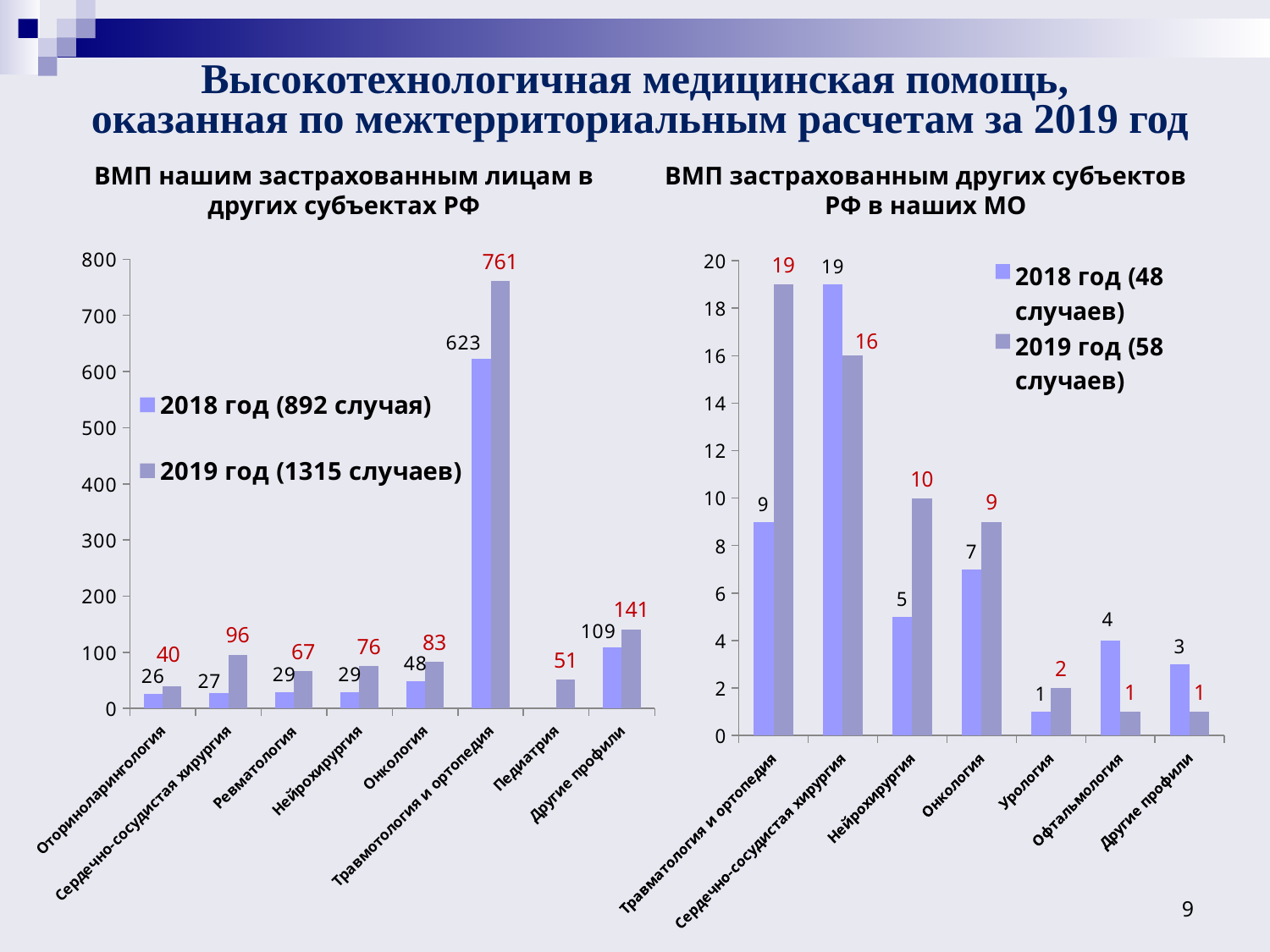
What type of chart is the right chart (ВМП застрахованным других субъектов РФ в наших МО)? Bar chart On the left chart (ВМП нашим застрахованным лицам в других субъектах РФ), which category has the highest 2019 value? Травматология и ортопедия On the right chart (ВМП застрахованным других субъектов РФ в наших МО), which category has the highest 2018 value? Сердечно-сосудистая хирургия On the left chart (ВМП нашим застрахованным лицам в других субъектах РФ), what is the difference between the 2019 and 2018 values for Другие профили? 32 On the left chart (ВМП нашим застрахованным лицам в других субъектах РФ), what is the 2019 value for Травматология и ортопедия? 761 On the right chart (ВМП застрахованным других субъектов РФ в наших МО), which is larger for Офтальмология: the 2018 value or the 2019 value? 2018 On the right chart (ВМП застрахованным других субъектов РФ в наших МО), what is the difference between the 2019 and 2018 values for Травматология и ортопедия? 10 On the right chart (ВМП застрахованным других субъектов РФ в наших МО), what total number of cases does the legend give for 2019? 58 случаев On the left chart (ВМП нашим застрахованным лицам в других субъектах РФ), what is the 2018 value for Онкология? 48 On the right chart (ВМП застрахованным других субъектов РФ в наших МО), what is the 2019 value for Нейрохирургия? 10 On the left chart (ВМП нашим застрахованным лицам в других субъектах РФ), how many series does the legend list? 2 On the left chart (ВМП нашим застрахованным лицам в других субъектах РФ), how many categories are shown on the x axis? 8